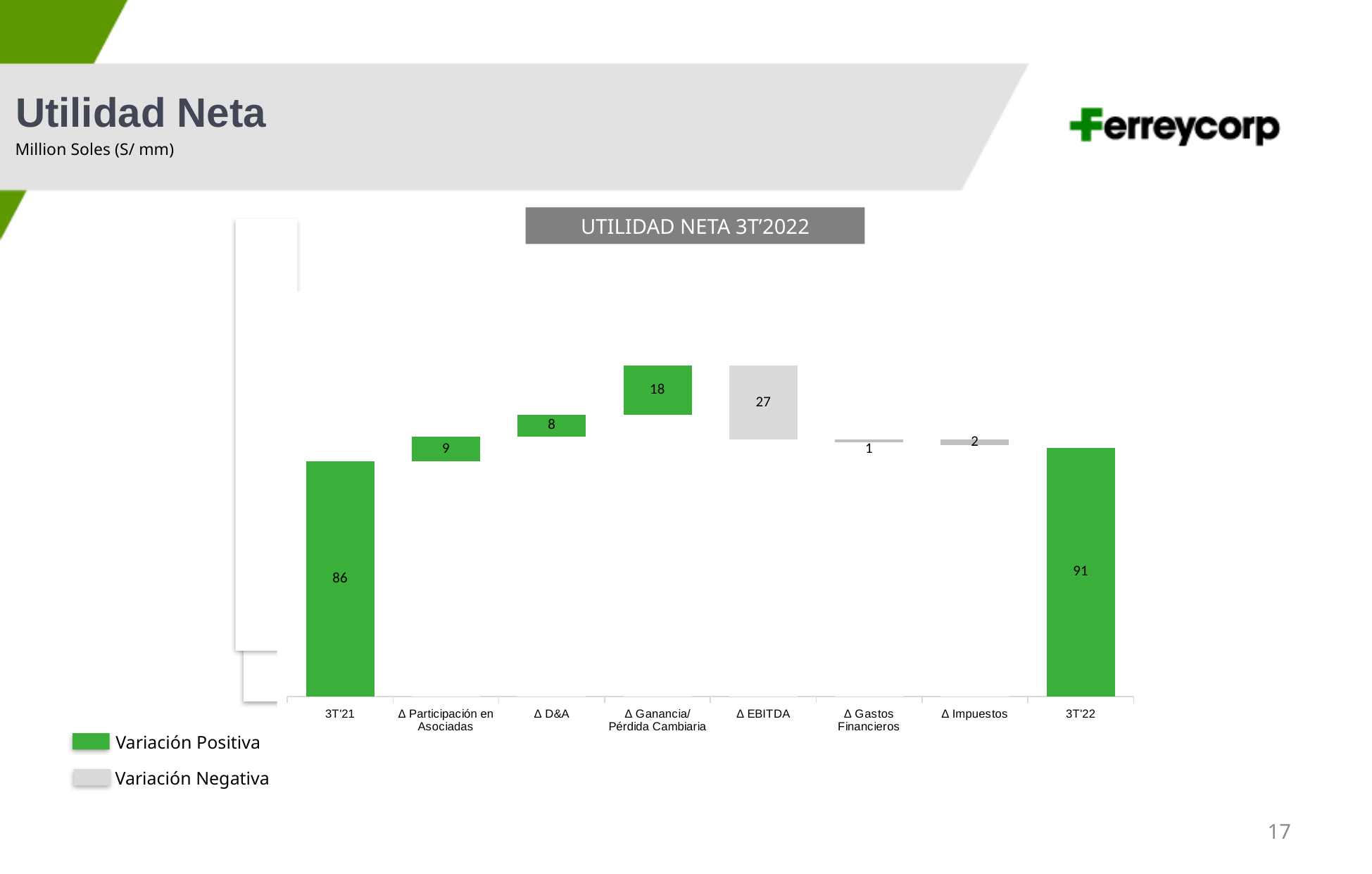
What is the value for 3T'21? 86 Which category has the smallest value shown? Δ Gastos Financieros What is the value shown for Δ EBITDA? 27 How many categories are shown on the x axis? 8 What is the value shown for Δ Participación en Asociadas? 9 Which legend entry is shown in grey? Variación Negativa How many entries does the legend list? 2 What kind of chart is shown on the slide? Bar chart (waterfall) What is the value for 3T'22? 91 Which is larger, the value for 3T'22 or the value for 3T'21? 3T'22 What is the value shown for Δ Ganancia/Pérdida Cambiaria? 18 What is the difference between the 3T'22 and 3T'21 values? 5